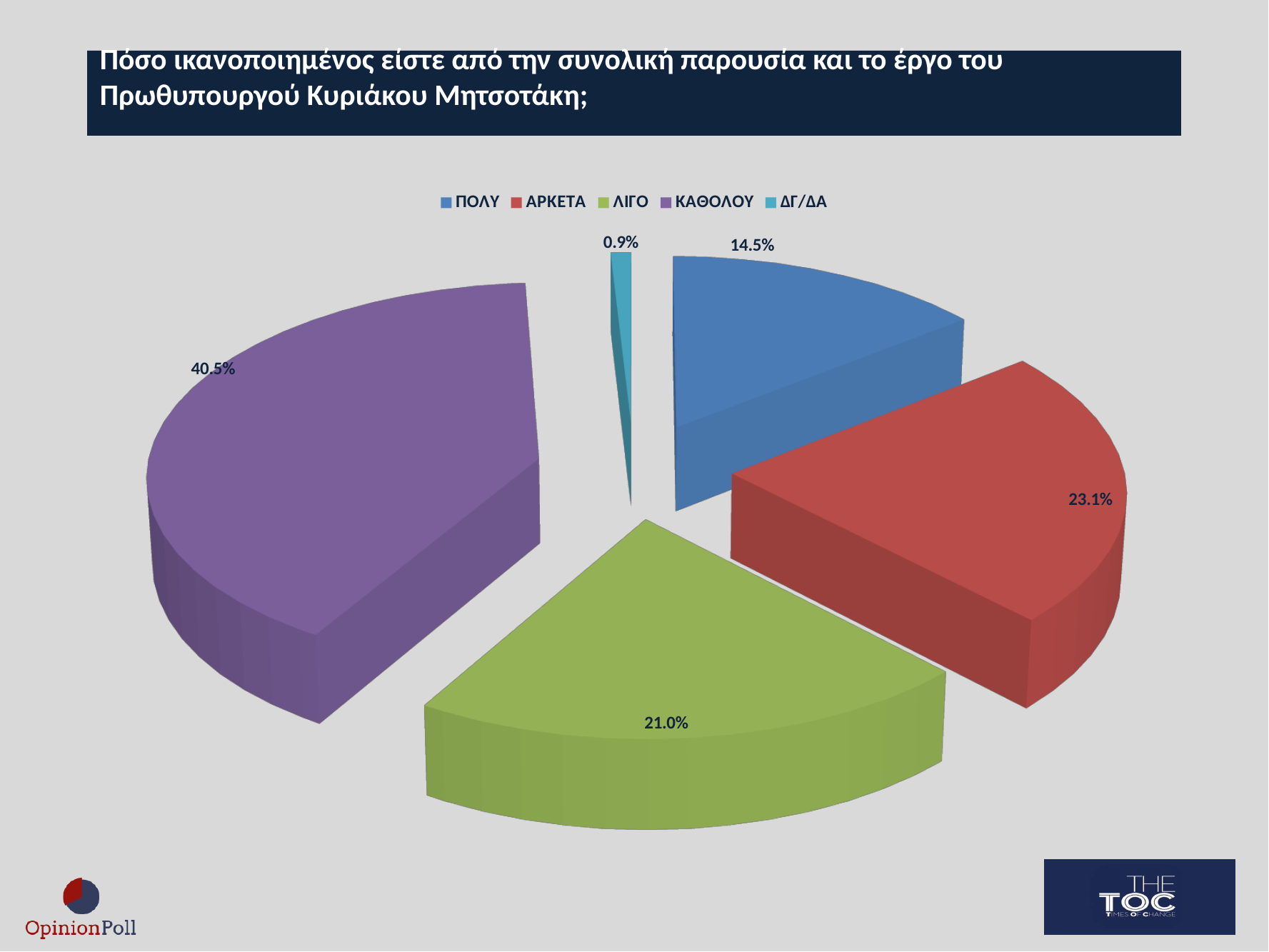
What is the difference in percentage points between ΚΑΘΟΛΟΥ and ΑΡΚΕΤΑ? 17.4 Which is larger, the share for ΑΡΚΕΤΑ or the share for ΛΙΓΟ? ΑΡΚΕΤΑ What kind of chart is shown on the slide? Pie chart What percentage is shown for ΠΟΛΥ? 14.5% Which category has the largest share of the pie? ΚΑΘΟΛΟΥ What percentage is shown for ΚΑΘΟΛΟΥ? 40.5% What percentage is shown for ΔΓ/ΔΑ? 0.9% What percentage is shown for ΛΙΓΟ? 21.0% Which category has the smallest share of the pie? ΔΓ/ΔΑ How many categories does the legend list? 5 What percentage is shown for ΑΡΚΕΤΑ? 23.1% What colour is the slice for ΚΑΘΟΛΟΥ? Purple